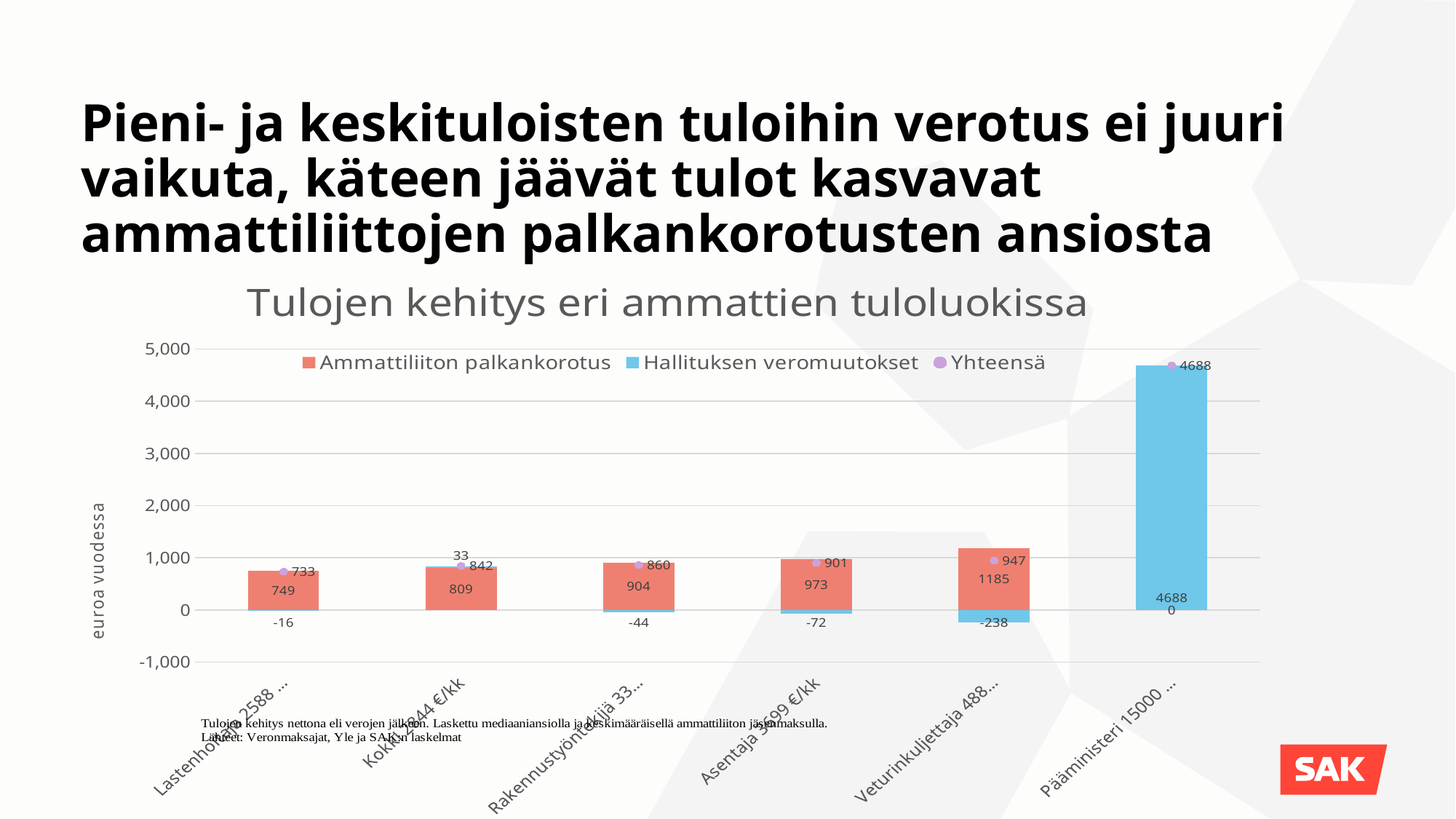
Which category has the lowest Hallituksen veromuutokset value? Veturinkuljettaja What kind of chart is shown on the slide? bar chart What is the Yhteensä value for Lastenhoitaja? 733 What is the Hallituksen veromuutokset value for Veturinkuljettaja? -238 How many series does the legend list? 3 Is the Hallituksen veromuutokset value for Pääministeri greater or less than 4,000? greater Which has the larger Yhteensä value, Kokki or Rakennustyöntekijä? Rakennustyöntekijä How many occupation categories are shown on the x axis? 6 How much larger is the Ammattiliiton palkankorotus for Veturinkuljettaja than for Asentaja 3699 €/kk? 212 What is the Hallituksen veromuutokset value for Kokki? 33 Which category has the highest Yhteensä value? Pääministeri What is the Ammattiliiton palkankorotus value for Asentaja 3699 €/kk? 973